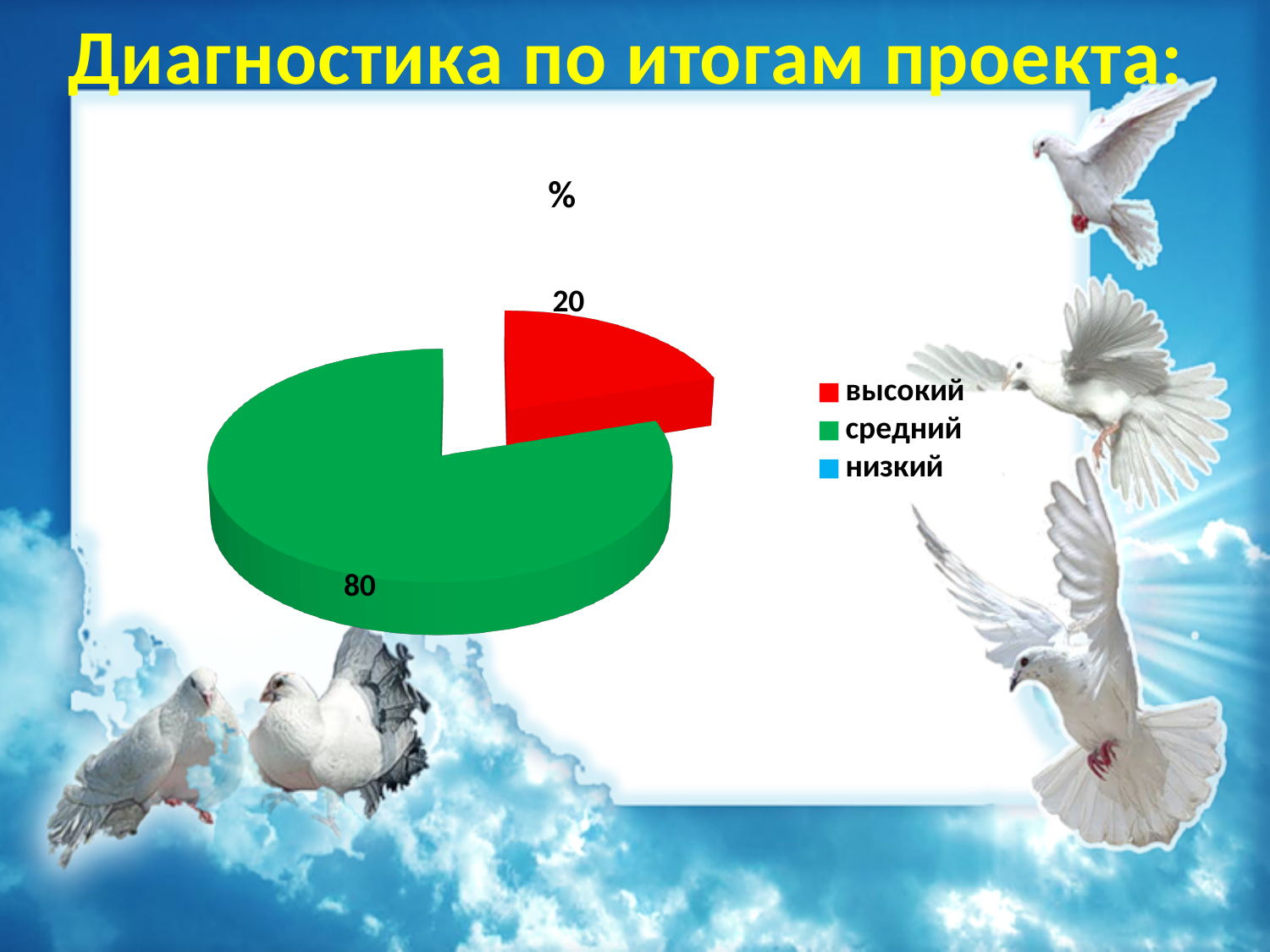
What is the value for the "высокий" slice? 20 Which of the two visible slices is larger, "высокий" or "средний"? средний How many slices with data labels are visible in the pie? 2 Which category has the largest slice of the pie? средний What is the title of the chart? % What is the difference between the "средний" value and the "высокий" value? 60 How many entries does the legend list? 3 What is the value for the "средний" slice? 80 What kind of chart is shown on the slide? pie chart What colour represents "средний" in the chart? green Is the value for "высокий" greater or less than 50? less